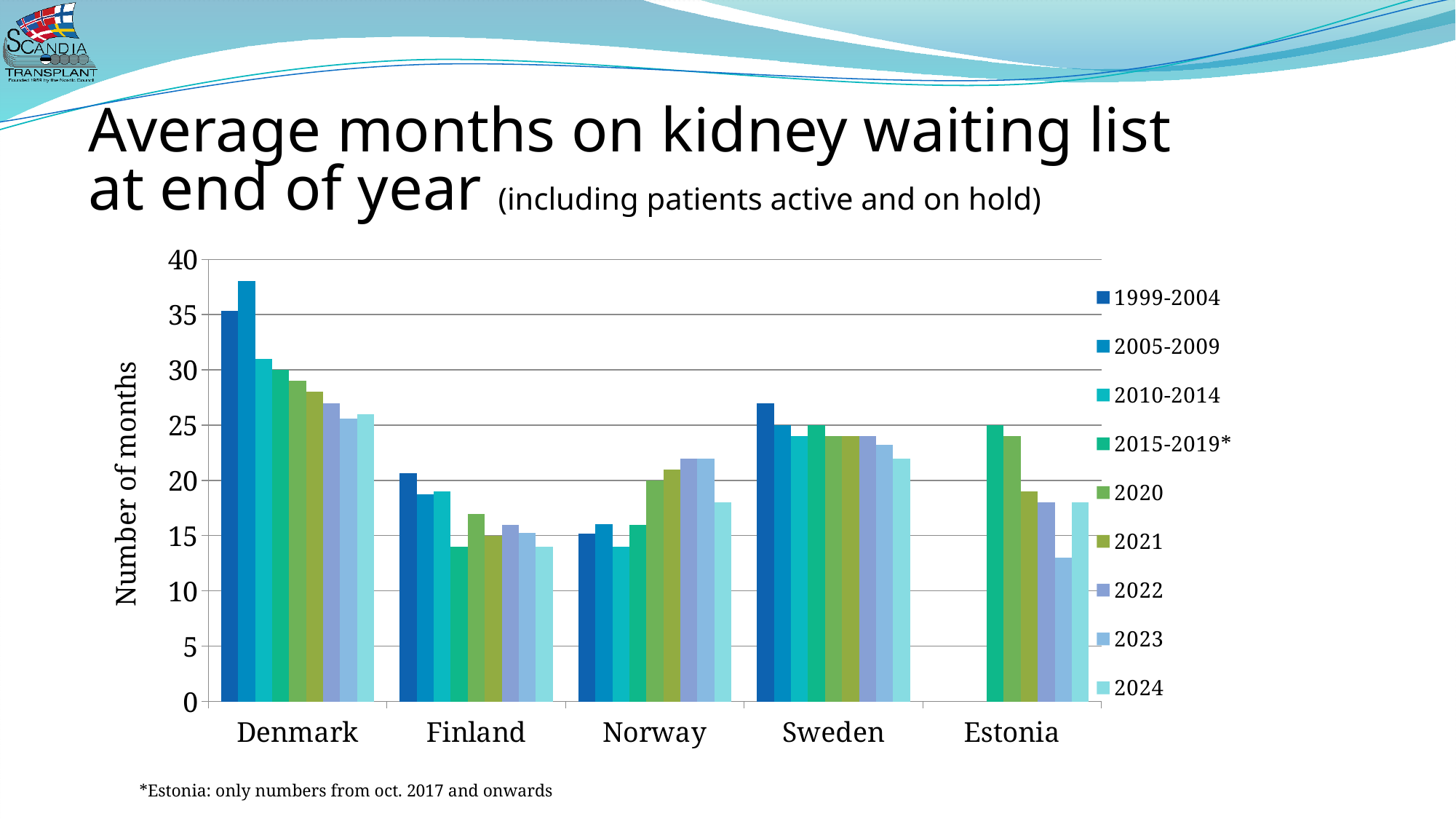
Is the value for Norway in 2022 greater or less than 20? greater Which country has the highest bar for 2005-2009? Denmark Is the value for Estonia in 2023 greater or less than 15? less For Estonia, which period has the lowest bar? 2023 Do the bars for Denmark generally rise or fall from 1999-2004 through 2024? fall How many series does the legend list? 9 Which is larger for 2024: Norway or Sweden? Sweden What is the title of the y axis? Number of months Which is larger for 1999-2004: Denmark or Sweden? Denmark How many countries are shown on the x axis? 5 What kind of chart is shown on the slide? bar chart Is the value for Denmark in 2005-2009 greater or less than 35? greater